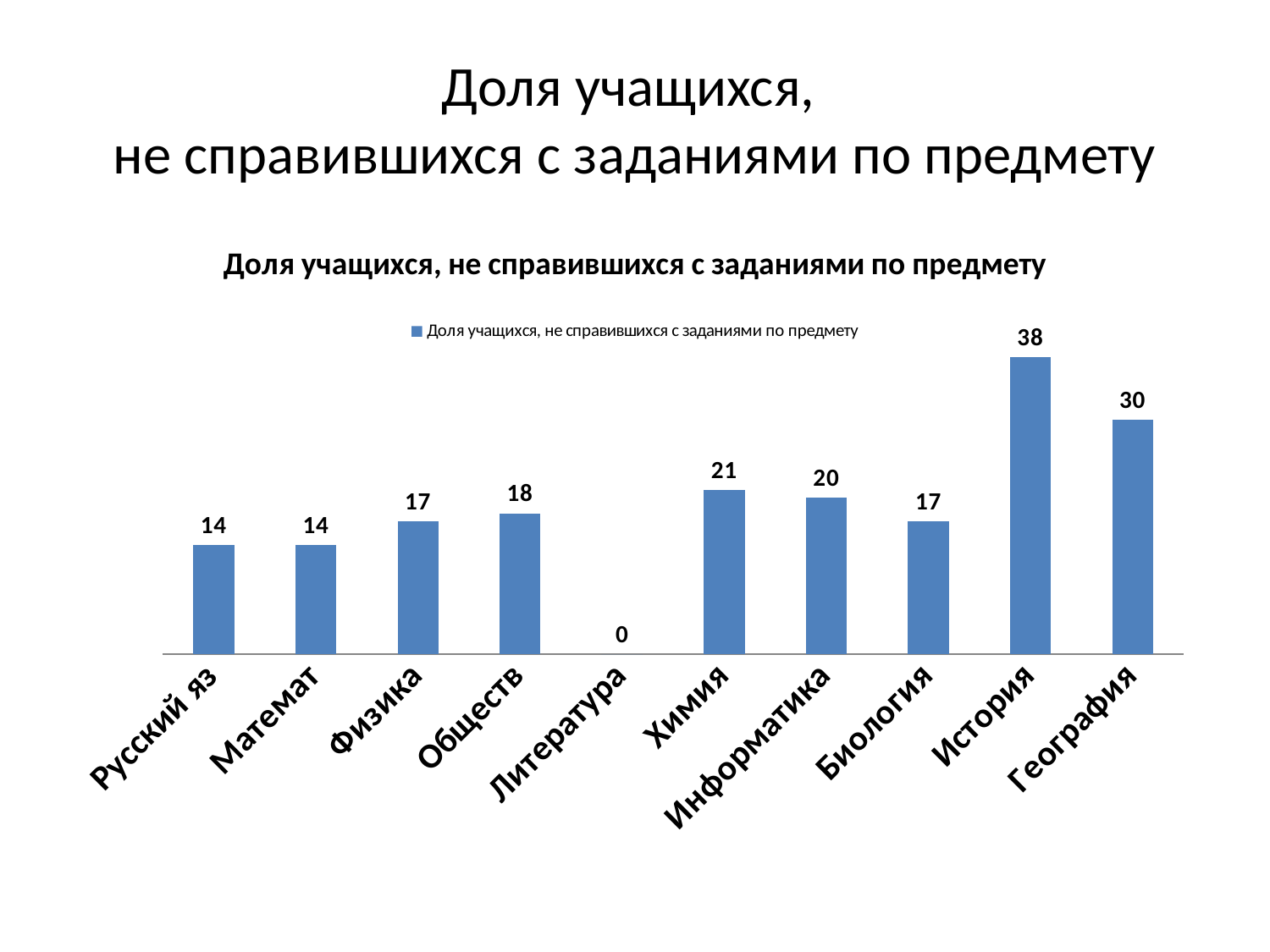
Which is larger, the value for Информатика or the value for Биология? Информатика How many categories are shown on the x axis? 10 How many series does the legend list? 1 Which category has the lowest value? Литература What is the difference between the values for Химия and Русский яз? 7 What is the value for Литература? 0 What is the value for История? 38 Which category has the highest value? История What kind of chart is shown? bar chart What is the difference between the values for История and География? 8 What is the value for Химия? 21 What is the title of the chart? Доля учащихся, не справившихся с заданиями по предмету